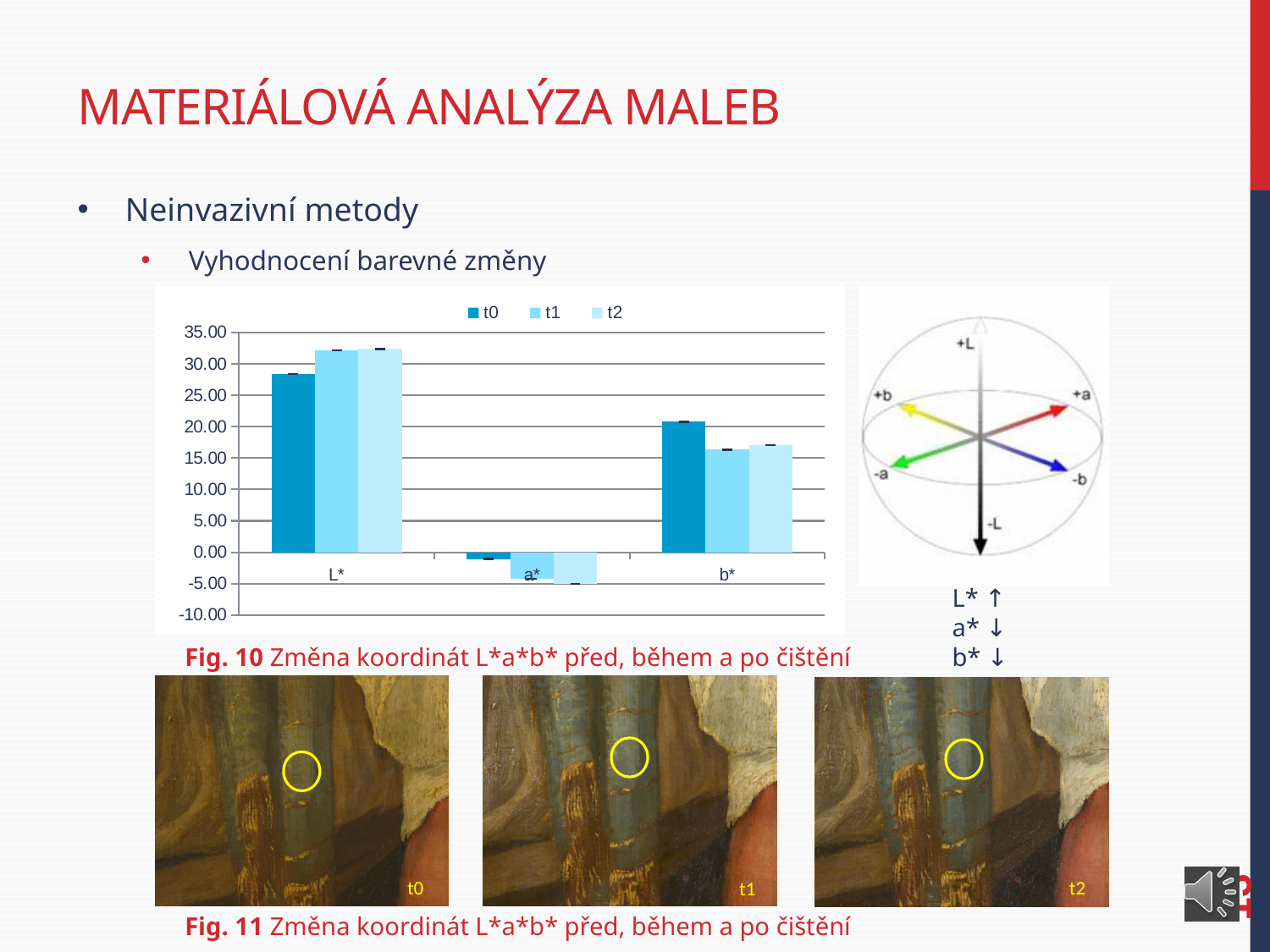
How many categories are shown on the x axis of the Fig. 10 chart? 3 In the Fig. 10 chart, which category has the highest bars? L* How many series does the legend of the Fig. 10 chart list? 3 In the Fig. 10 chart, which series has the lowest value for L*? t0 What are the legend entries of the Fig. 10 chart? t0, t1, t2 In the Fig. 10 chart, which series has the highest value for b*? t0 What kind of chart is shown in Fig. 10? bar chart In the Fig. 10 chart, is the t1 value for b* greater or less than 20.00? less In the Fig. 10 chart, does the b* value rise or fall from t0 to t1? fall In the Fig. 10 chart, which category has the lowest (negative) bars? a* In the Fig. 10 chart, is the t0 value for L* greater or less than 25.00? greater In the Fig. 10 chart, which is larger for L*: the t0 value or the t1 value? t1